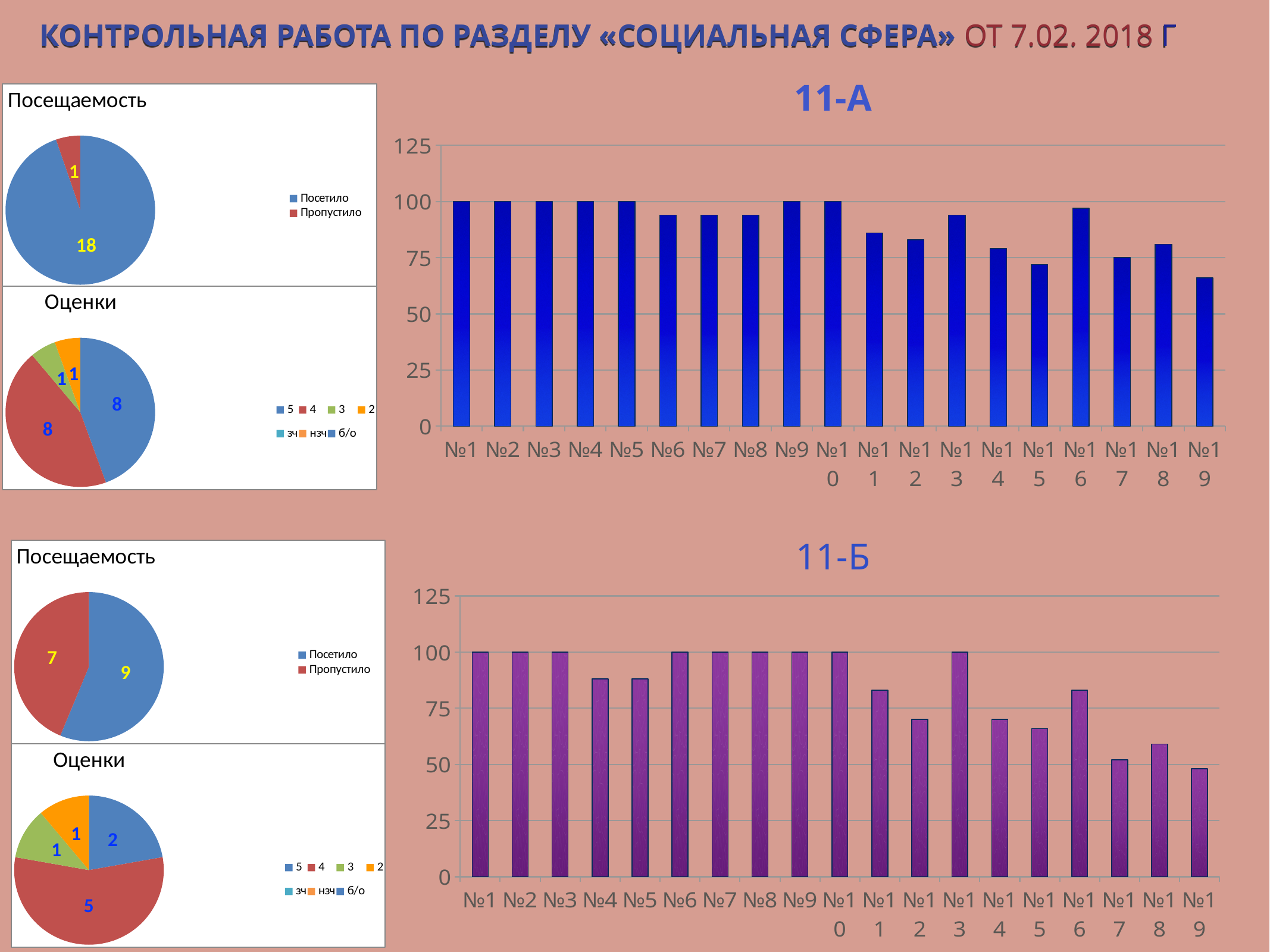
In the bottom-left 'Оценки' pie chart (for 11-Б), which grade has the largest slice? 4 In the bottom-left 'Оценки' pie chart (for 11-Б), what is the value for grade 5? 2 In the top-left 'Оценки' pie chart (for 11-А), what is the total of all the labelled slices? 18 What kind of chart is the '11-Б' chart? bar chart In the '11-А' bar chart, is the value for №19 greater or less than 75? less In the '11-А' bar chart, how many categories are shown on the x axis? 19 In the bottom-left 'Посещаемость' pie chart (for 11-Б), which is larger, 'Посетило' or 'Пропустило'? Посетило In the top-left 'Посещаемость' pie chart, what is the difference between 'Посетило' and 'Пропустило'? 17 In the '11-А' bar chart, which category has the lowest value? №19 In the top-left 'Посещаемость' pie chart, what is the value for 'Посетило'? 18 In the top-left 'Оценки' pie chart (for 11-А), how many students received a grade of 3? 1